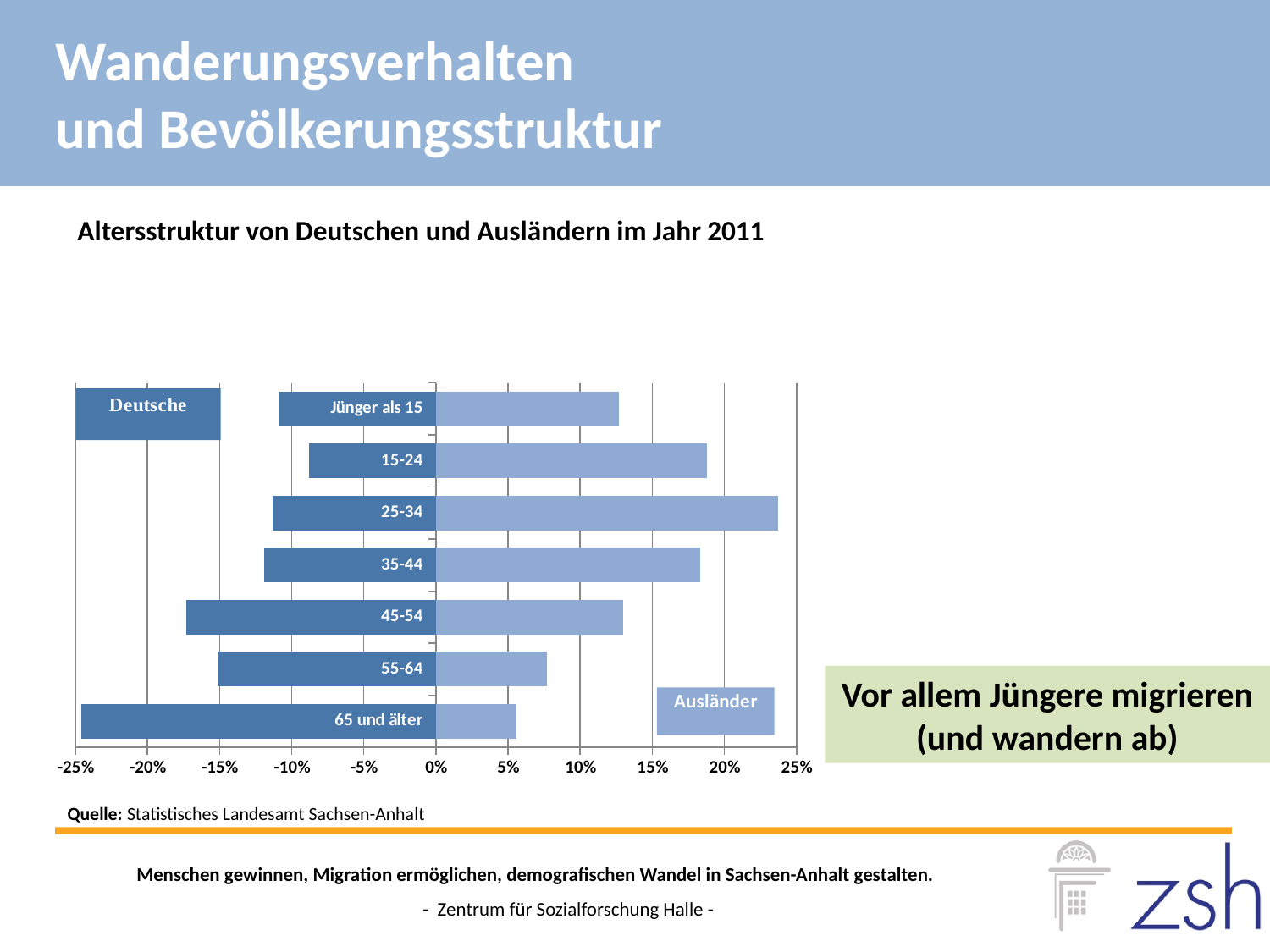
Which age group has the largest share among Deutsche? 65 und älter Among Deutsche, which age group has a larger share: 65 und älter or 15-24? 65 und älter Is the Ausländer value for the 65 und älter age group greater or less than 10%? less How many series does the chart show? 2 What kind of chart is shown on the slide? bar chart Among Ausländer, which age group has a larger share: 15-24 or 55-64? 15-24 Which age group has the smallest share among Ausländer? 65 und älter Which age group has the largest share among Ausländer? 25-34 How many age groups are shown in the chart? 7 Is the Ausländer value for the 25-34 age group greater or less than 20%? greater What is the title of the chart? Altersstruktur von Deutschen und Ausländern im Jahr 2011 Is the Deutsche value for the 45-54 age group greater or less than 15% in magnitude? greater